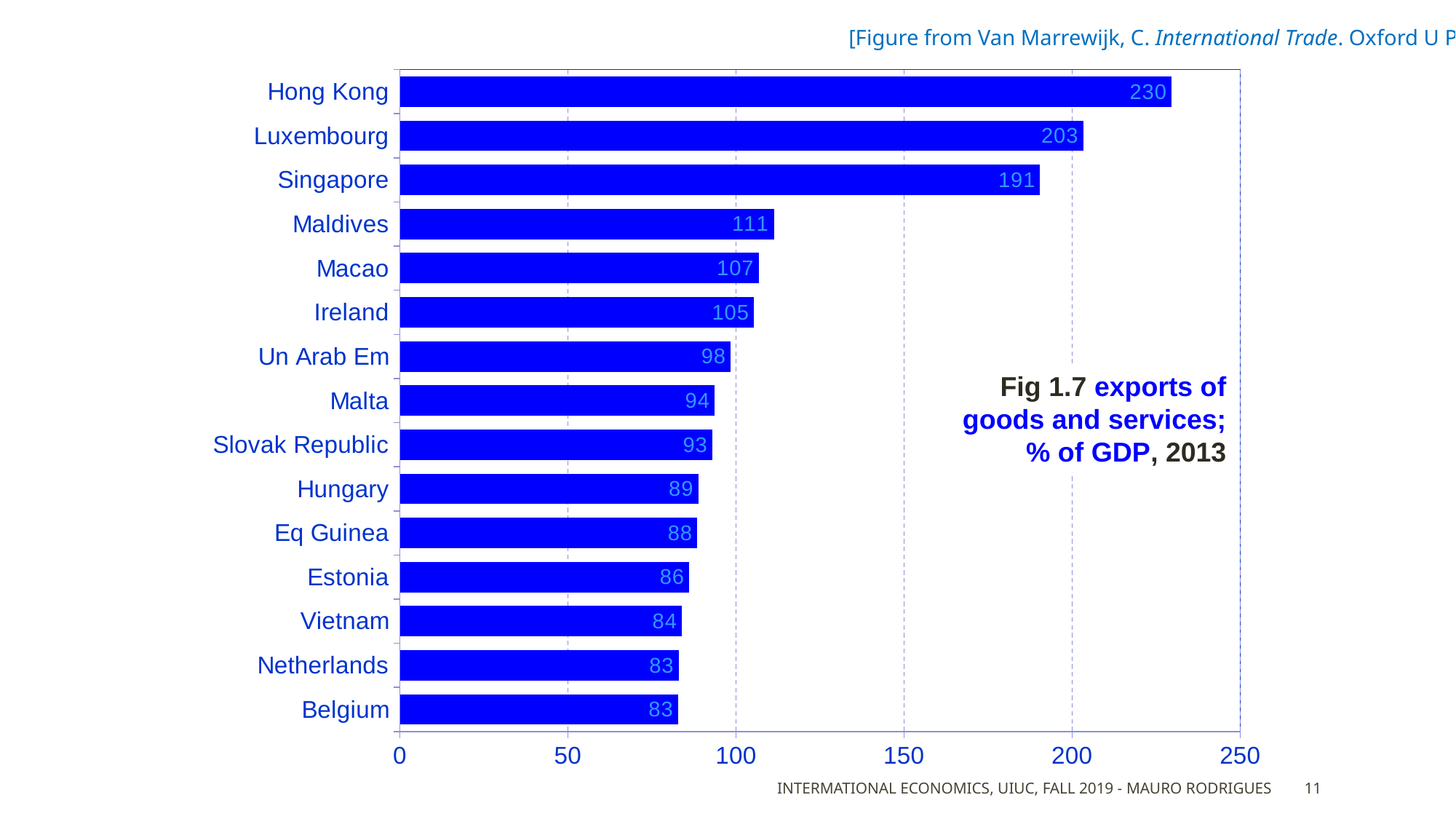
What kind of chart is shown on the slide? bar chart What is the difference between the values for Hong Kong and Luxembourg? 27 How many countries are shown in the chart? 15 Is the value for Singapore greater or less than 150? greater Which country has the highest value? Hong Kong Which has a larger value, Macao or Malta? Macao Is the value for Hungary greater or less than 100? less What is the value for Ireland? 105 What year does the chart's data refer to, according to the figure caption? 2013 What is the value for Vietnam? 84 What is the value for Hong Kong? 230 What is the difference between the values for Singapore and Maldives? 80